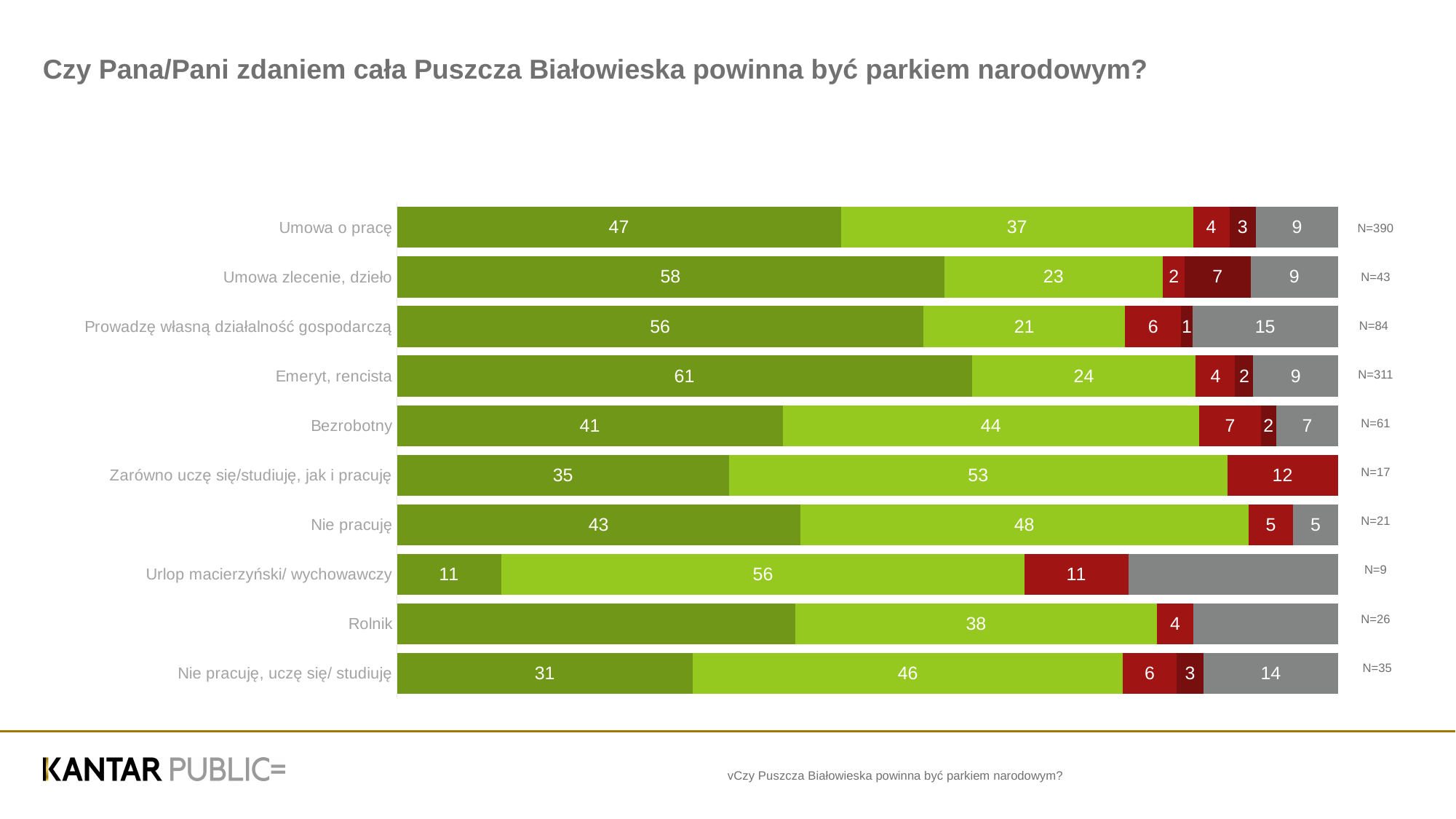
What is the sample size (N) shown for "Umowa o pracę"? N=390 What is the total of the labelled segments in the "Umowa o pracę" bar? 100 How many categories (employment groups) are shown on the chart? 10 For "Umowa o pracę", what is the difference between the dark green segment and the light green segment? 10 What is the value of the light green segment for "Bezrobotny"? 44 What is the value of the dark green segment for "Emeryt, rencista"? 61 Which category has the largest light green segment? Urlop macierzyński/ wychowawczy Which has a larger light green segment: "Zarówno uczę się/studiuję, jak i pracuję" or "Nie pracuję"? Zarówno uczę się/studiuję, jak i pracuję What kind of chart is shown on the slide? bar chart Which category has the largest dark green segment? Emeryt, rencista What is the value of the grey segment for "Prowadzę własną działalność gospodarczą"? 15 Which category has the smallest dark green segment? Urlop macierzyński/ wychowawczy